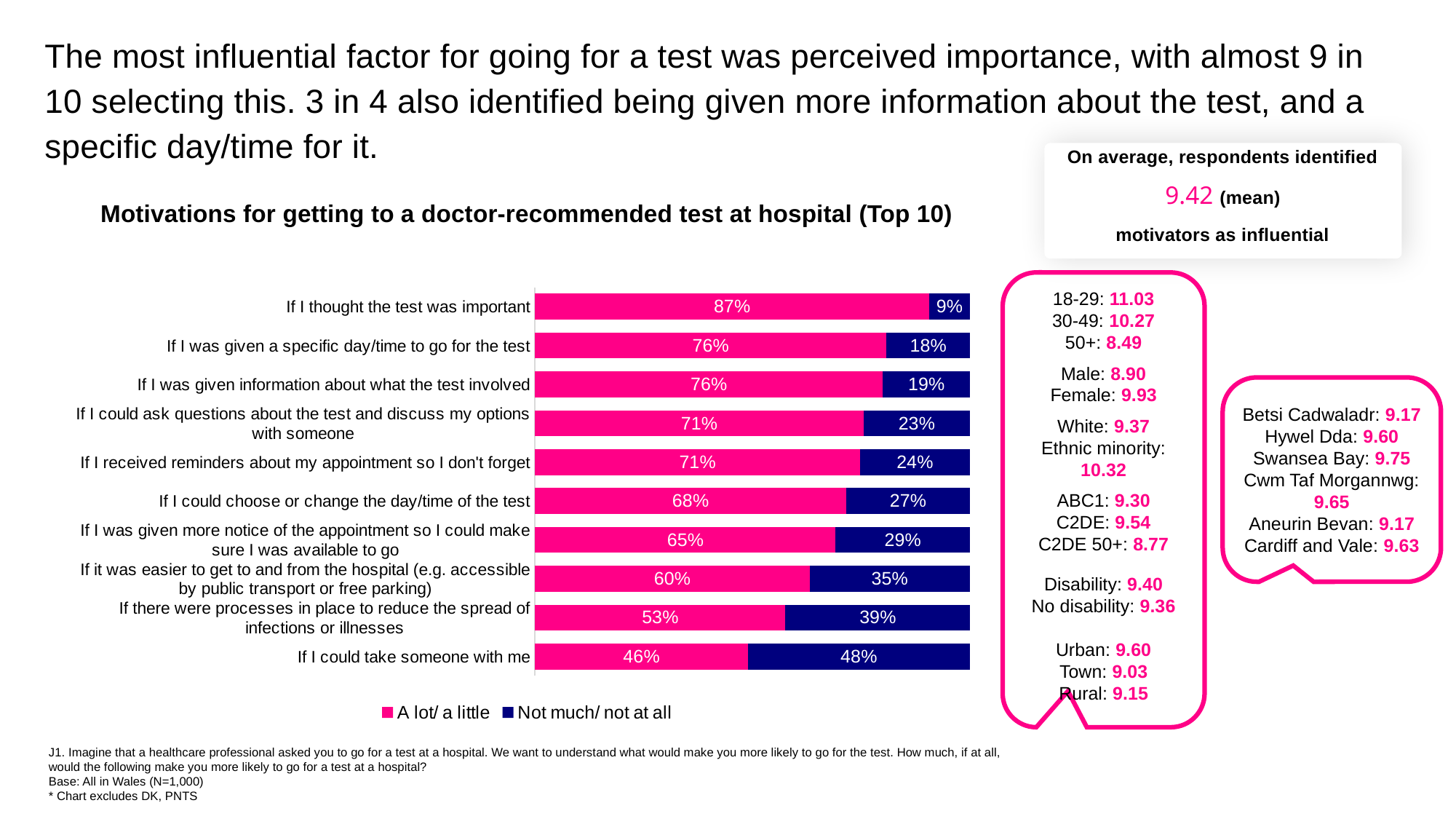
What percentage said 'A lot/ a little' for 'If I thought the test was important'? 87% How many motivations are shown in the chart? 10 Which motivation has the lowest 'A lot/ a little' percentage? If I could take someone with me What percentage said 'Not much/ not at all' for 'If I could take someone with me'? 48% What is the 'A lot/ a little' value for 'If it was easier to get to and from the hospital (e.g. accessible by public transport or free parking)'? 60% What is the difference between the 'A lot/ a little' values for 'If I thought the test was important' and 'If I could take someone with me'? 41 percentage points What is the title of the chart? Motivations for getting to a doctor-recommended test at hospital (Top 10) What is the total of the two labelled segments for 'If there were processes in place to reduce the spread of infections or illnesses'? 92% Which has a larger 'Not much/ not at all' share: 'If I received reminders about my appointment so I don't forget' or 'If I could choose or change the day/time of the test'? If I could choose or change the day/time of the test What kind of chart is shown on the slide? Stacked horizontal bar chart Which motivation has the highest 'A lot/ a little' percentage? If I thought the test was important How many series does the legend list? 2